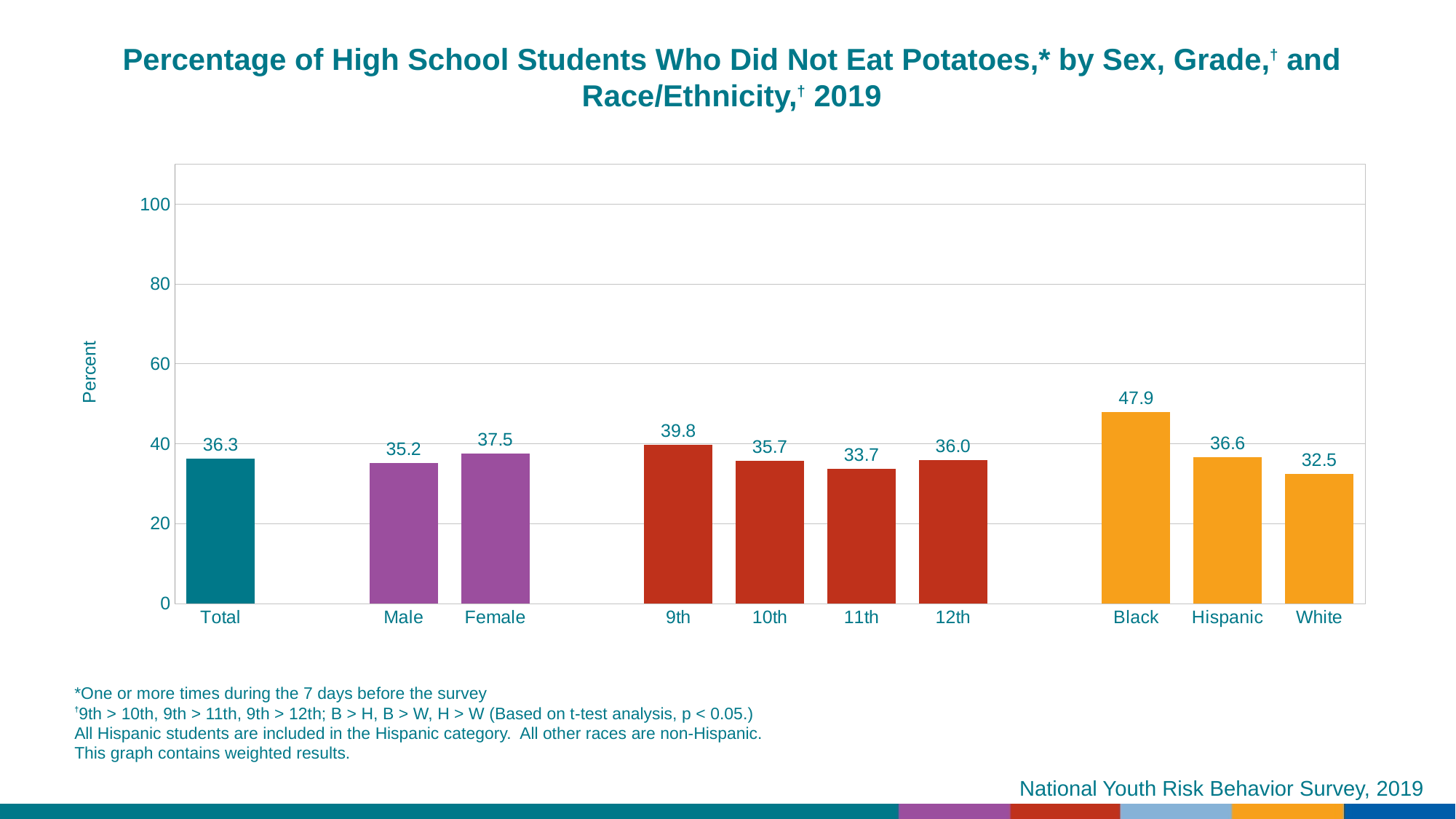
How many categories are shown on the x axis? 10 Which category has the highest value? Black What is the value for Total? 36.3 Which is larger, the value for 9th grade or 12th grade? 9th Which category has the lowest value? White What is the value for Black students? 47.9 What is the difference between the Female and Male values? 2.3 What is the value for 11th grade? 33.7 Is the value for Hispanic greater or less than 40? less What kind of chart is this? bar chart What is the difference between the Black and White values? 15.4 What is the label of the y axis? Percent